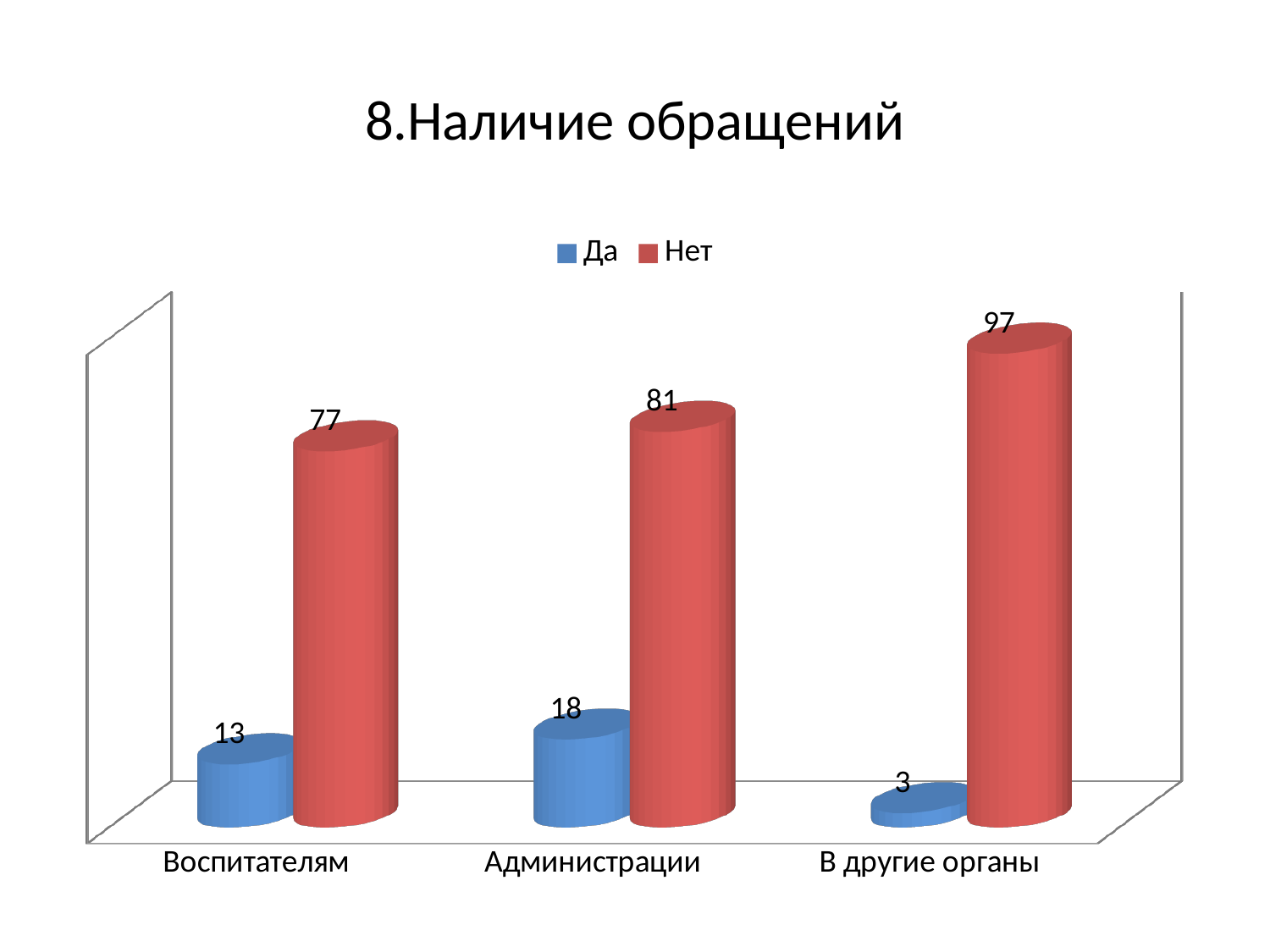
Which is larger: the "Да" value for "Администрации" or the "Да" value for "Воспитателям"? Администрации What is the value for "Да" in the "В другие органы" category? 3 What is the value for "Да" in the "Воспитателям" category? 13 What is the value for "Нет" in the "В другие органы" category? 97 What kind of chart is shown on the slide? Bar chart What is the difference between the "Нет" and "Да" values for "Воспитателям"? 64 What is the title of the slide? 8.Наличие обращений How many categories are shown on the x axis? 3 How many series does the legend list? 2 What is the value for "Нет" in the "Администрации" category? 81 Which category has the highest value for "Нет"? В другие органы Which category has the lowest value for "Да"? В другие органы